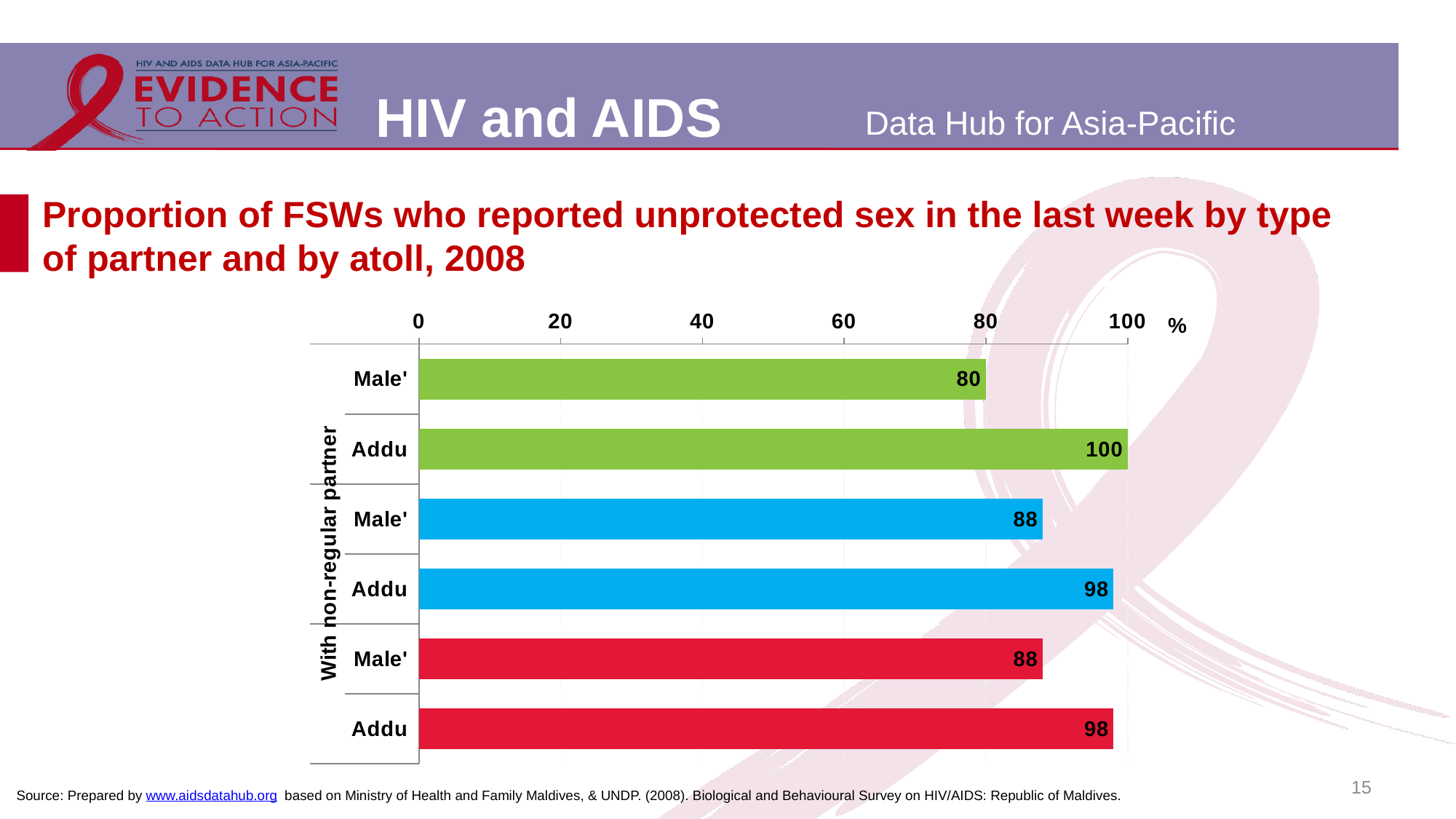
What is the value of the red bar for Addu (bottom bar)? 98 Which bar has the lowest value in the chart? Male' (green bar), 80 How many bars are plotted in the chart? 6 What is the difference between the green Addu bar and the green Male' bar? 20 What is the value of the blue bar for Male'? 88 Among the blue bars, which is larger: Addu or Male'? Addu What is the value of the green bar for Addu? 100 What is the value of the green bar for Male' (top bar)? 80 What unit is shown at the end of the horizontal axis? % Which bar has the highest value in the chart? Addu (green bar), 100 What kind of chart is shown on the slide? bar chart What is the difference between the red Addu bar and the red Male' bar? 10